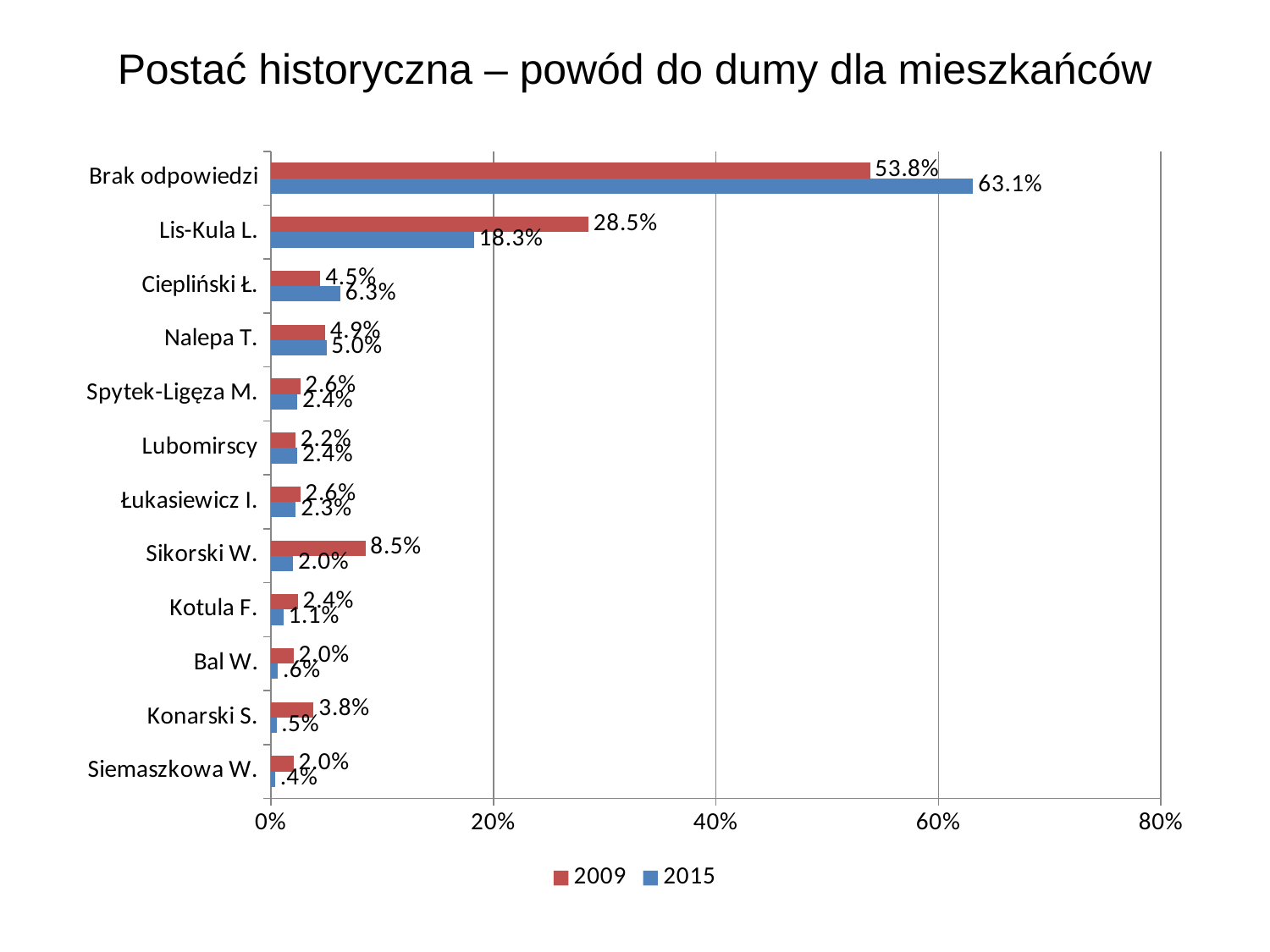
What is the value for Lis-Kula L. in the 2009 series? 28.5% What is the value for Brak odpowiedzi in the 2015 series? 63.1% Is the 2009 value for Brak odpowiedzi greater or less than 40%? greater What is the difference between the 2015 and 2009 values for Brak odpowiedzi? 9.3 percentage points Which category has the highest value in the 2015 series? Brak odpowiedzi For Lis-Kula L., which series has the larger value, 2009 or 2015? 2009 How many categories are shown on the chart? 12 How many series does the legend list? 2 What is the difference between the 2009 and 2015 values for Lis-Kula L.? 10.2 percentage points Which category has the lowest value in the 2015 series? Siemaszkowa W. What is the value for Sikorski W. in the 2015 series? 2.0% What is the value for Sikorski W. in the 2009 series? 8.5%